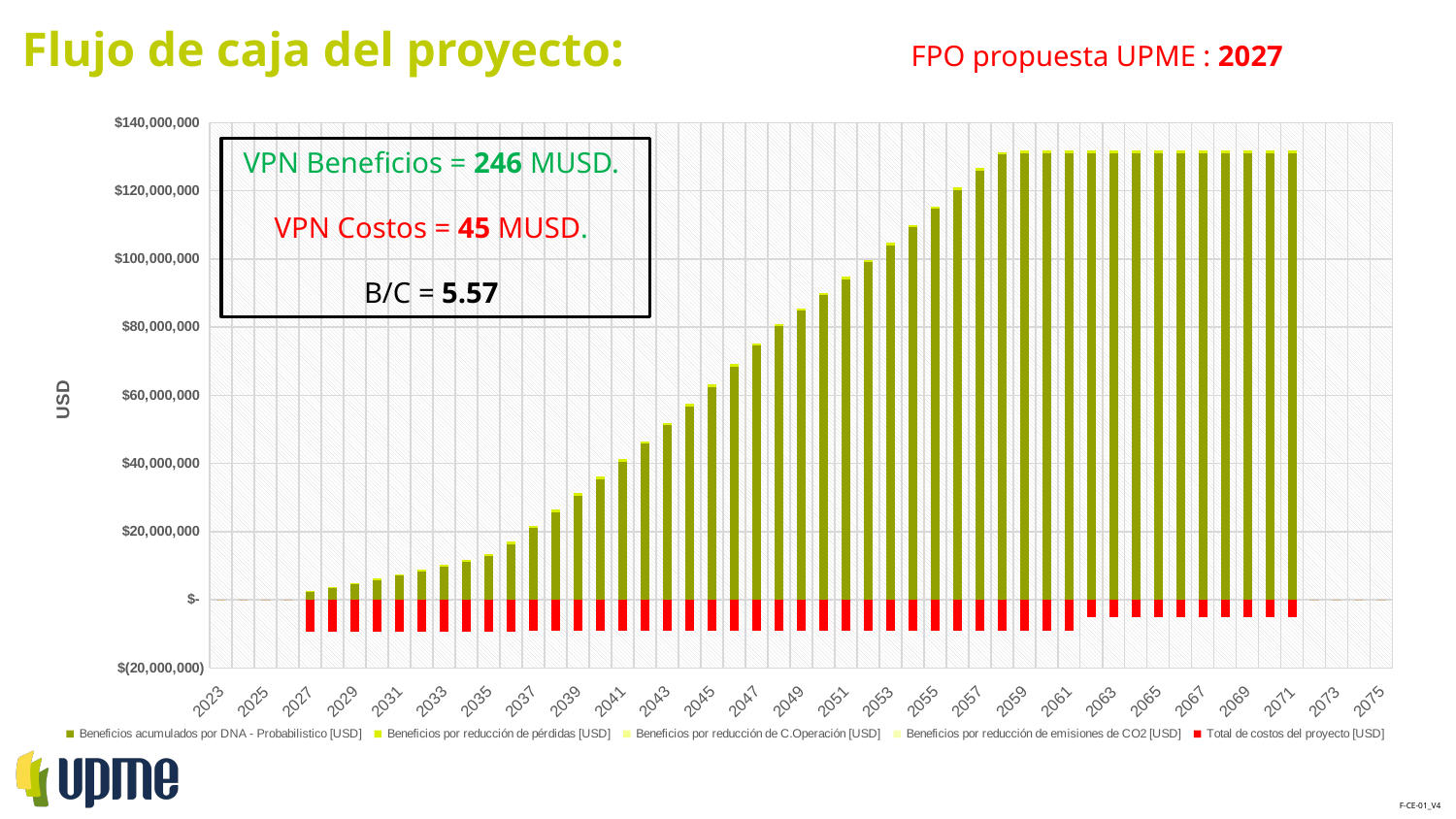
Is the value of the red 'Total de costos del proyecto' bar for 2027 greater or less than $-? less What is the title of the slide containing the chart? Flujo de caja del proyecto: Is the value of the green benefit bar for 2027 greater or less than $20,000,000? less Which year has the larger green benefit bar, 2039 or 2049? 2049 In which year do the bars first appear on the chart? 2027 Is the value of the green benefit bar for 2047 greater or less than $80,000,000? less How many series does the chart legend list? 5 What kind of chart is shown on the slide? bar chart Do the green benefit bars rise or fall from 2027 to 2057 along the x axis? rise Which year has the lowest green benefit bar among the years with bars? 2027